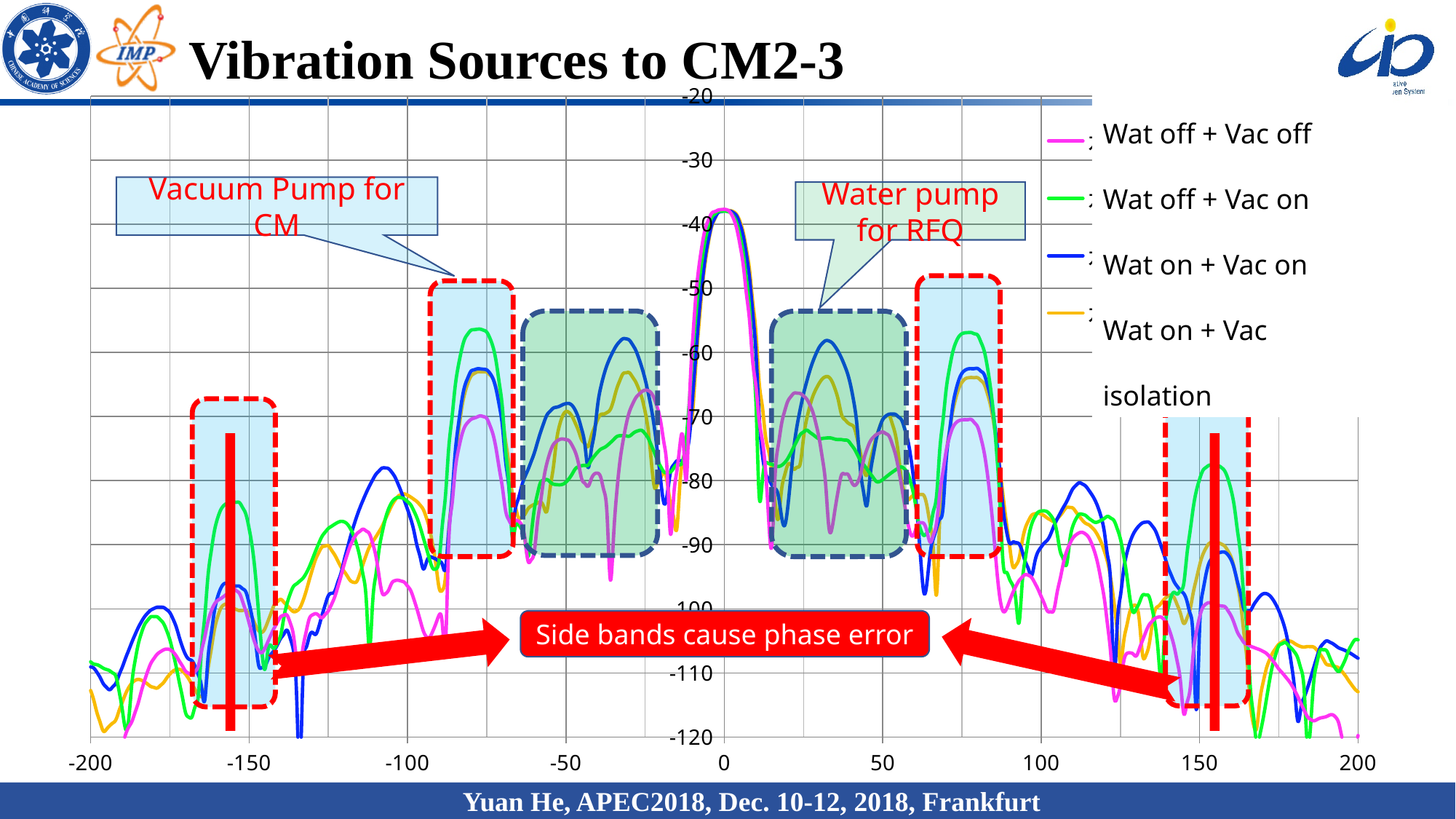
Near x = -75, which series reaches the highest value? Wat off + Vac on Near x = 150, is the peak of the Wat off + Vac on series greater or less than -90? greater Which legend entry is drawn in magenta? Wat off + Vac off Near x = 75, is the peak of the Wat off + Vac off series greater or less than -80? greater Near x = -75, is the peak of the Wat off + Vac on series greater or less than -60? greater What kind of chart is shown on the slide? line chart Near x = -75, which series has the lowest peak? Wat off + Vac off How many series does the legend list? 4 Near x = -30, which is higher: the Wat on + Vac on series or the Wat off + Vac off series? Wat on + Vac on Which legend entry is drawn in green? Wat off + Vac on